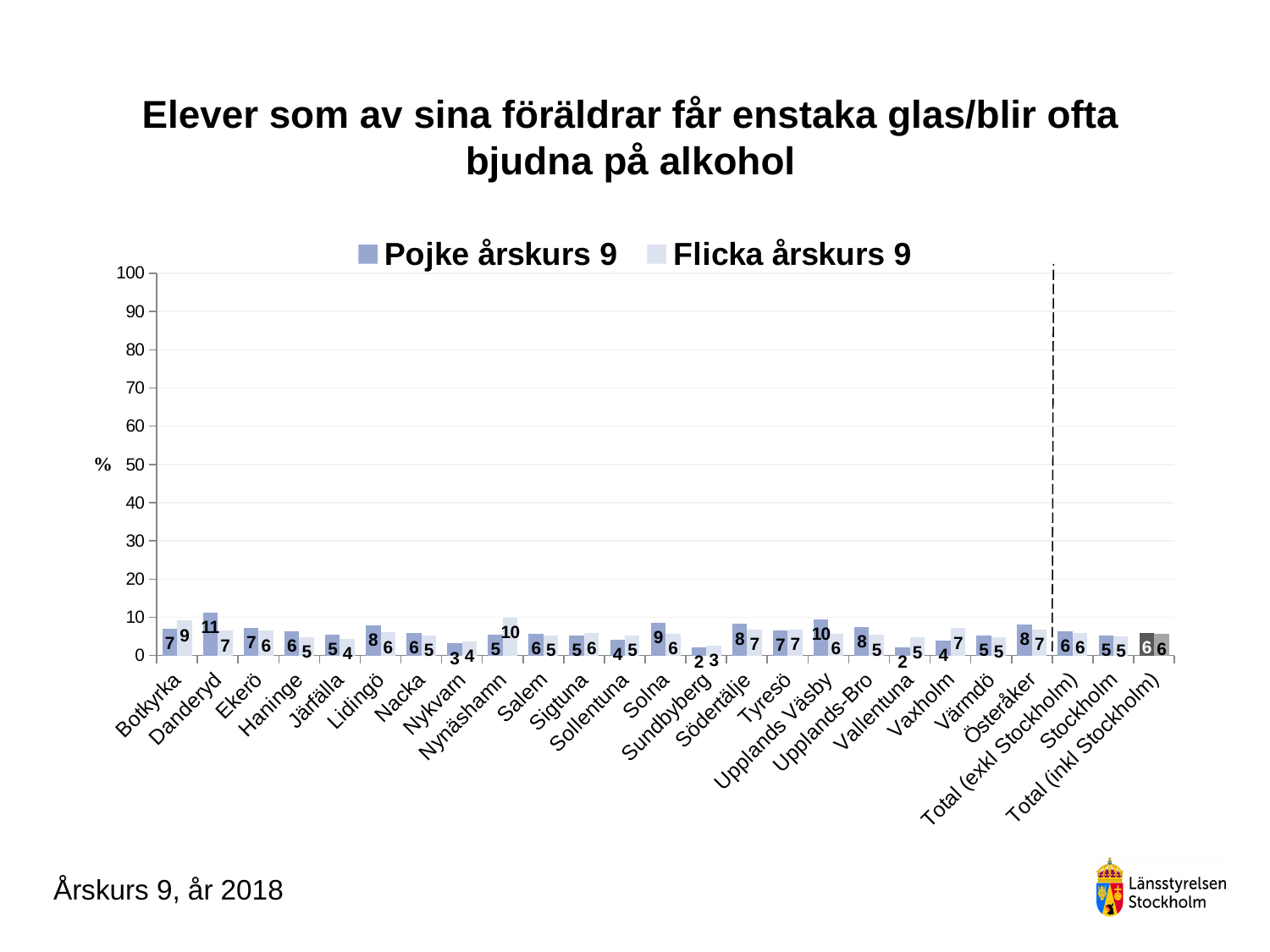
What is the difference between the Pojke årskurs 9 and Flicka årskurs 9 values in Nynäshamn? 5 How many series does the legend list? 2 What is the value for Pojke årskurs 9 in Danderyd? 11 Is the value for Pojke årskurs 9 in Danderyd greater or less than 10? greater What kind of chart is shown on the slide? Bar chart What is the value for Pojke årskurs 9 in Upplands Väsby? 10 Which is larger in Vaxholm, the Pojke årskurs 9 value or the Flicka årskurs 9 value? Flicka årskurs 9 Which category has the highest value for Pojke årskurs 9? Danderyd What is the value for Flicka årskurs 9 in Nynäshamn? 10 Which category has the lowest value for Flicka årskurs 9? Sundbyberg What is the value for Flicka årskurs 9 in Stockholm? 5 How many categories are shown on the x axis? 25